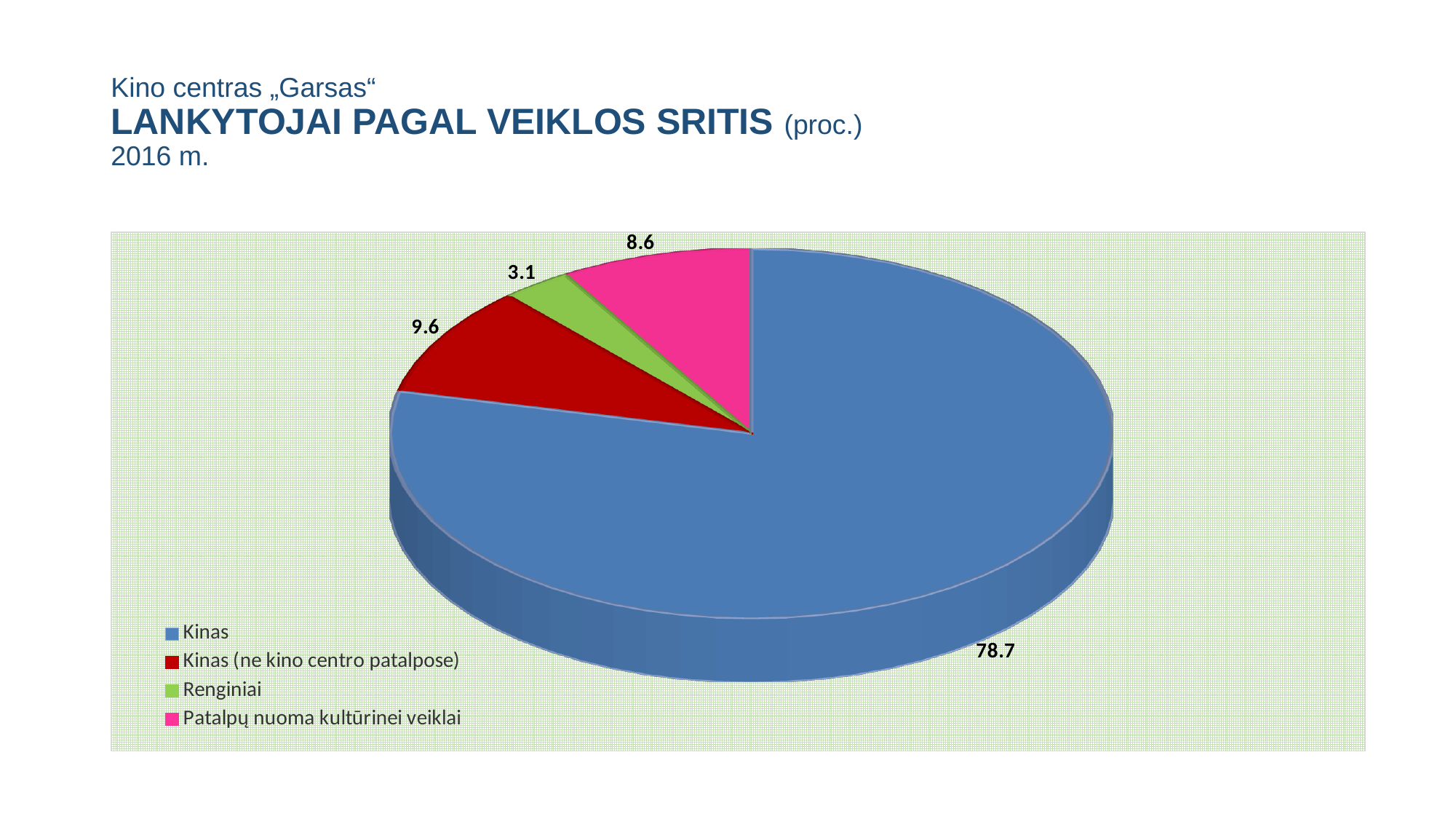
How many categories does the pie chart show? 4 Which colour represents Renginiai in the legend? green What is the difference between the values for Kinas (ne kino centro patalpose) and Patalpų nuoma kultūrinei veiklai? 1.0 Which category has the largest slice? Kinas Which is larger, the value for Renginiai or the value for Patalpų nuoma kultūrinei veiklai? Patalpų nuoma kultūrinei veiklai What is the value for Patalpų nuoma kultūrinei veiklai? 8.6 Which category has the smallest slice? Renginiai What is the value for Renginiai? 3.1 What kind of chart is shown on the slide? pie chart What is the difference between the values for Kinas and Kinas (ne kino centro patalpose)? 69.1 What is the value for Kinas? 78.7 What is the value for Kinas (ne kino centro patalpose)? 9.6